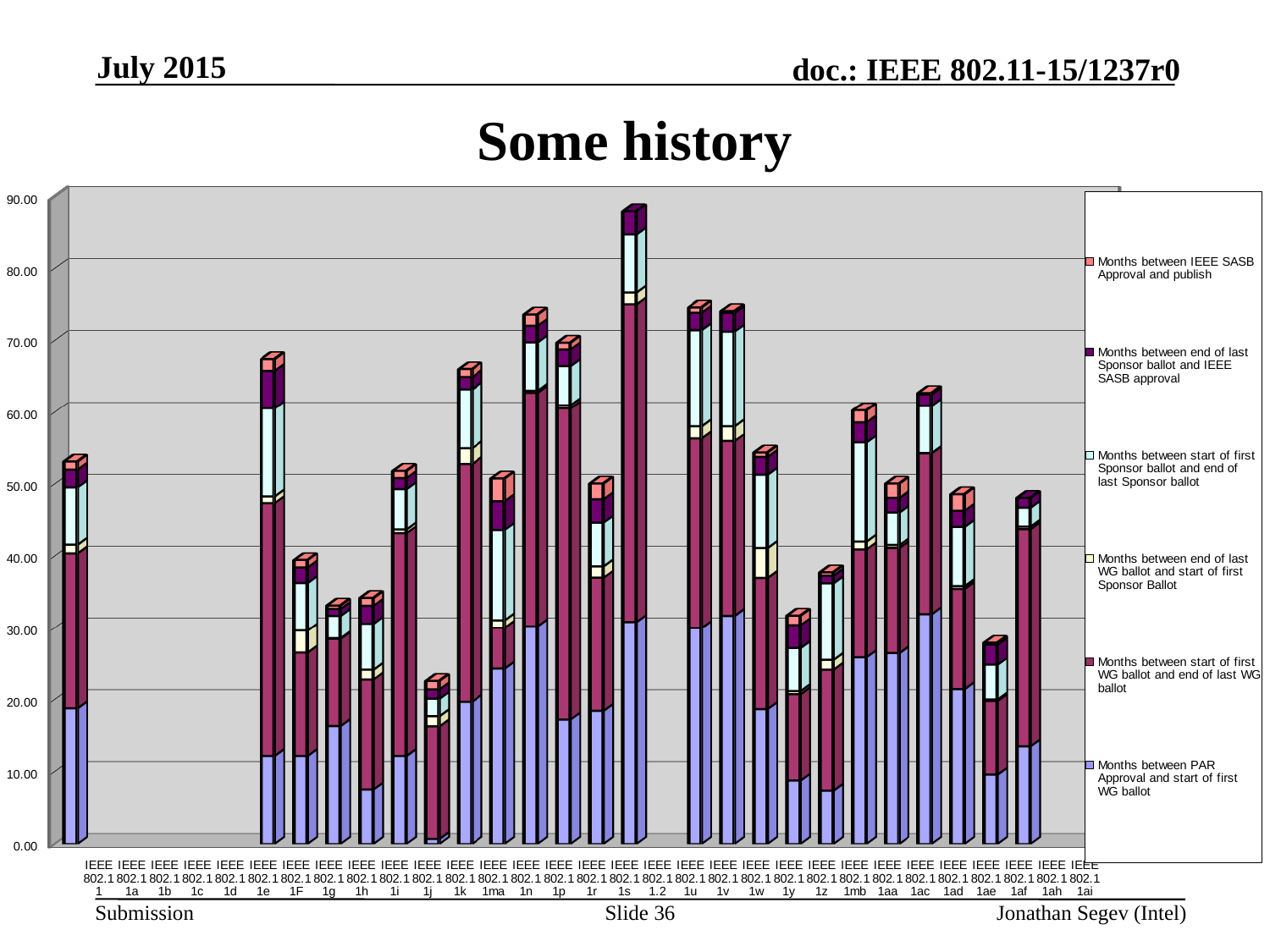
Is the total for IEEE 802.11s greater or less than 80? greater Which has the taller stacked bar, IEEE 802.11e or IEEE 802.11F? IEEE 802.11e Which category has the tallest stacked bar? IEEE 802.11s What is the title of the slide containing the chart? Some history Which has the taller stacked bar, IEEE 802.11k or IEEE 802.11g? IEEE 802.11k Is the total for IEEE 802.11j greater or less than 30? less Which has the taller stacked bar, IEEE 802.11ae or IEEE 802.11ac? IEEE 802.11ac Is the total for IEEE 802.11y greater or less than 40? less What kind of chart is shown on the slide? stacked bar chart How many series does the legend list? 6 Which series does the bottom (blue) segment of each bar represent, according to the legend? Months between PAR Approval and start of first WG ballot